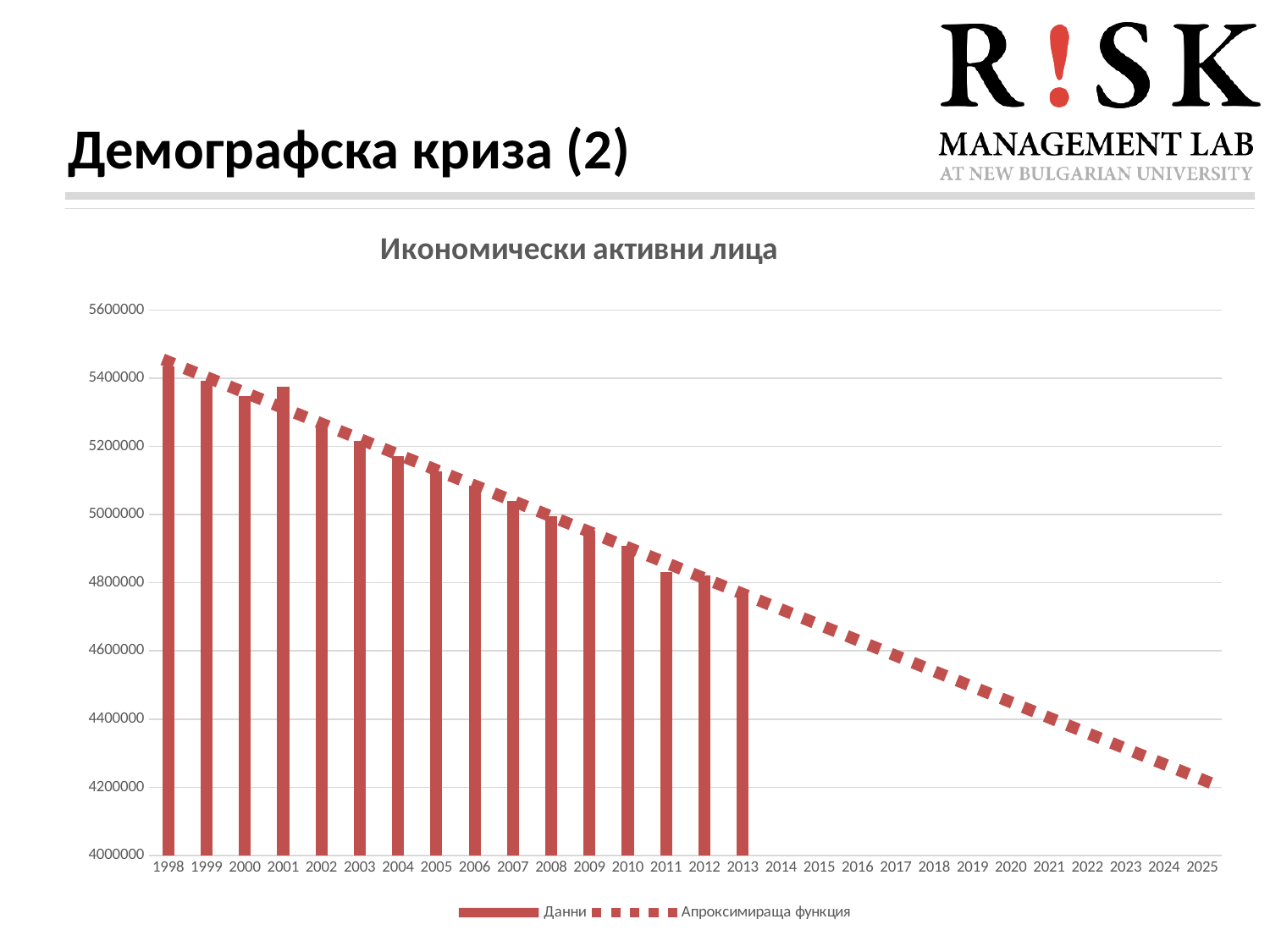
Is the value for 1998 greater or less than 5400000? greater What are the two legend entries of the chart? Данни and Апроксимираща функция How many years have a data bar plotted in the chart? 16 Which is larger, the value for 2004 or the value for 2009? 2004 Do the bar values rise or fall from 1998 to 2013? fall What kind of chart is shown on the slide? Bar chart with a dashed trend line Which year has the lowest bar? 2013 Is the value for 2011 greater or less than 5000000? less What is the title of the chart? Икономически активни лица How many series does the legend list? 2 How many years are labelled on the x axis? 28 Which year has the highest bar? 1998